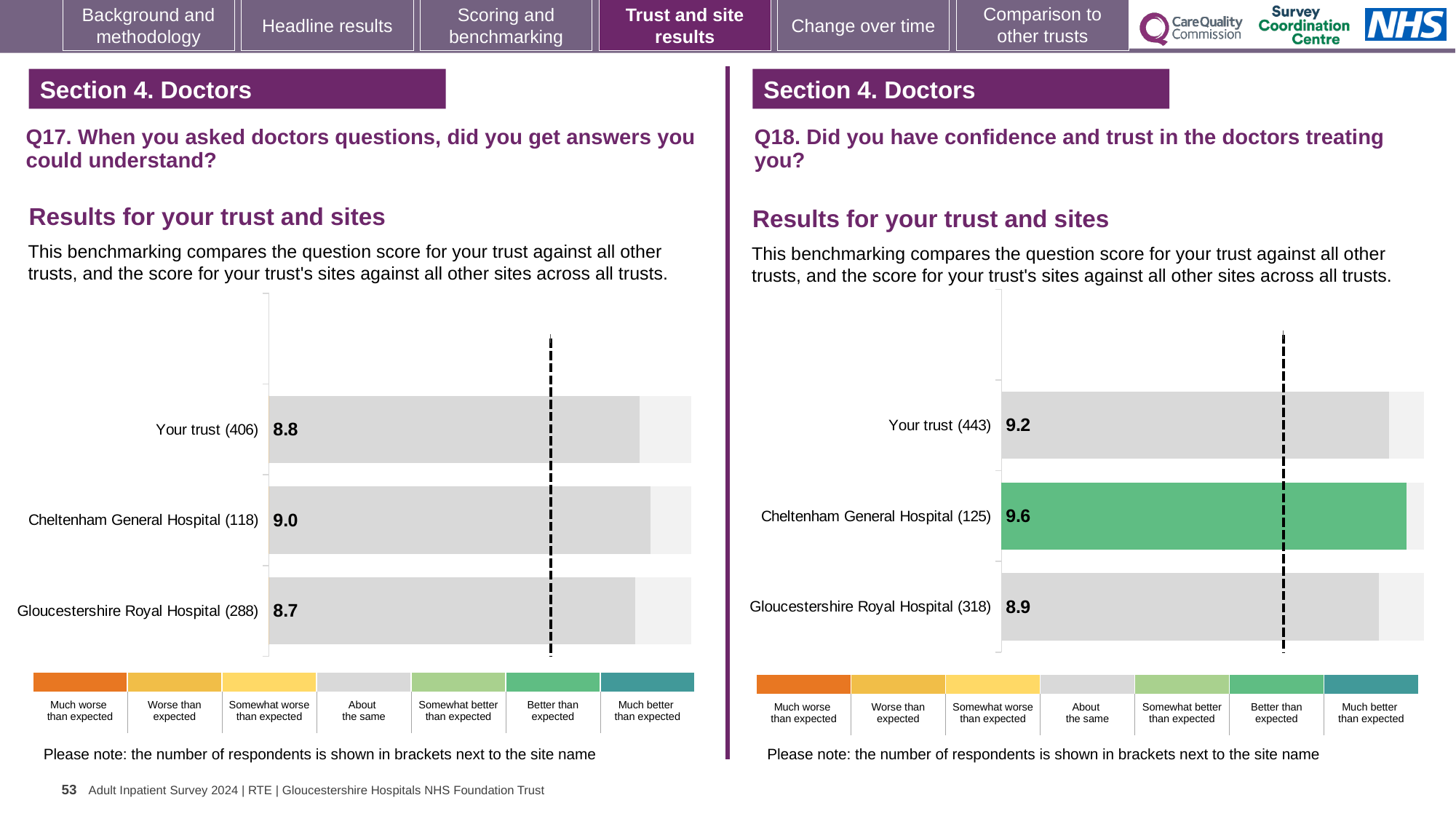
In the Q18 chart on the right, what is the difference between the scores for Cheltenham General Hospital and Gloucestershire Royal Hospital? 0.7 In the Q18 chart on the right, which has the larger score: Your trust or Gloucestershire Royal Hospital? Your trust In the Q18 chart on the right, which site or trust has the highest score? Cheltenham General Hospital In the Q17 chart on the left, what is the difference between the scores for Cheltenham General Hospital and Your trust? 0.2 In the Q17 chart on the left, which site or trust has the lowest score? Gloucestershire Royal Hospital In the Q18 chart on the right, how many respondents are shown in brackets for Your trust? 443 In the Q17 chart on the left, what is the score for Cheltenham General Hospital? 9.0 In the Q18 chart on the right, what is the score for Gloucestershire Royal Hospital? 8.9 What kind of chart is used for the Q18 results on the right? Bar chart How many bars are plotted in the Q17 chart on the left? 3 In the Q17 chart on the left, what is the score for Your trust? 8.8 In the Q18 chart on the right, which benchmark category does the green colour of the Cheltenham General Hospital bar represent according to the legend? Better than expected